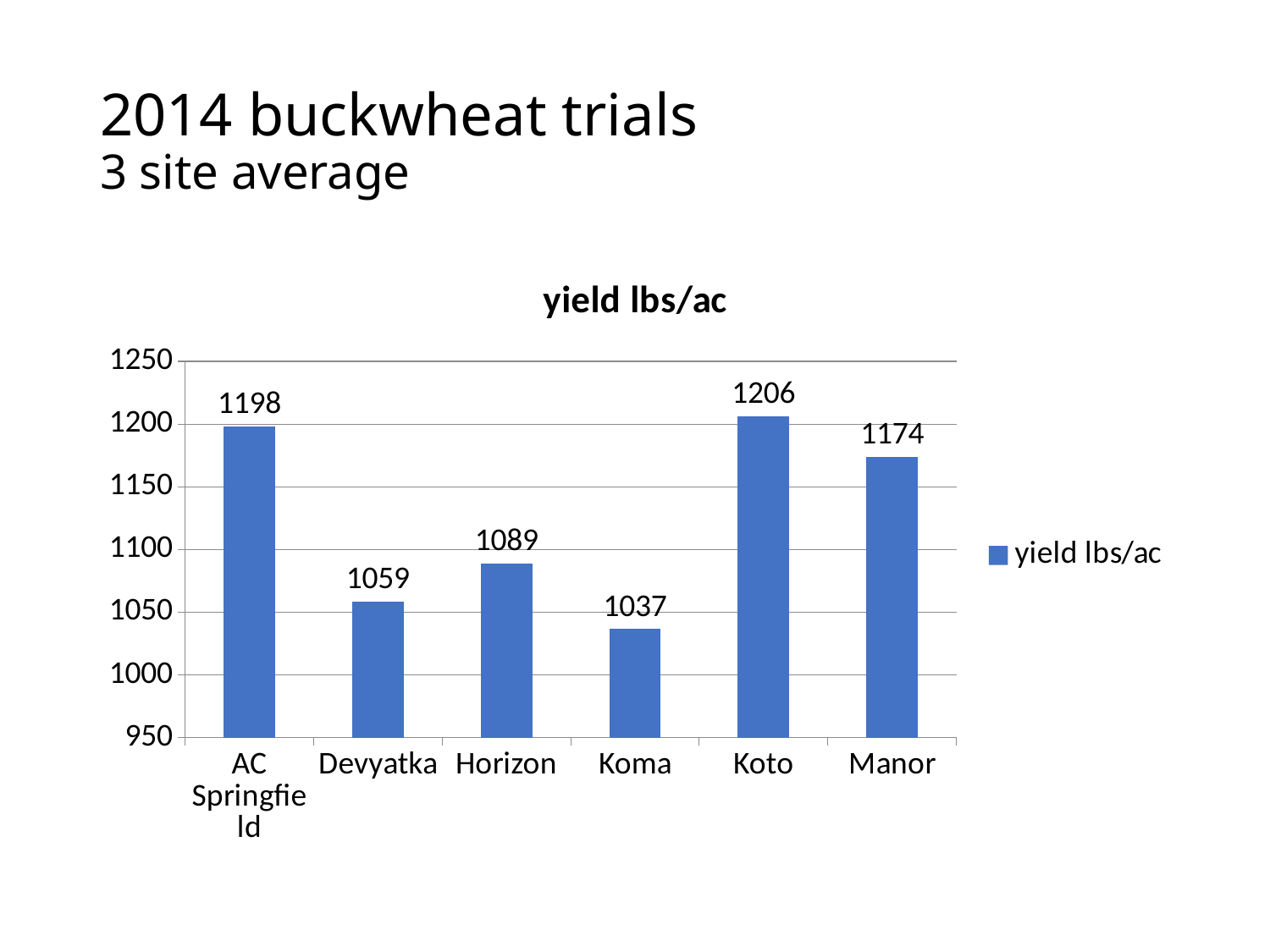
What is the title of the chart? yield lbs/ac Which variety has the lowest yield? Koma What is the yield for Koto? 1206 What is the difference in yield between Manor and Horizon? 85 Is the value for Manor greater or less than 1150? greater Which variety has the highest yield? Koto What is the yield for AC Springfield? 1198 What kind of chart is shown on the slide? bar chart Which has a higher yield, Horizon or Devyatka? Horizon What is the yield for Devyatka? 1059 How many varieties are shown in the chart? 6 What is the difference in yield between Koto and Koma? 169